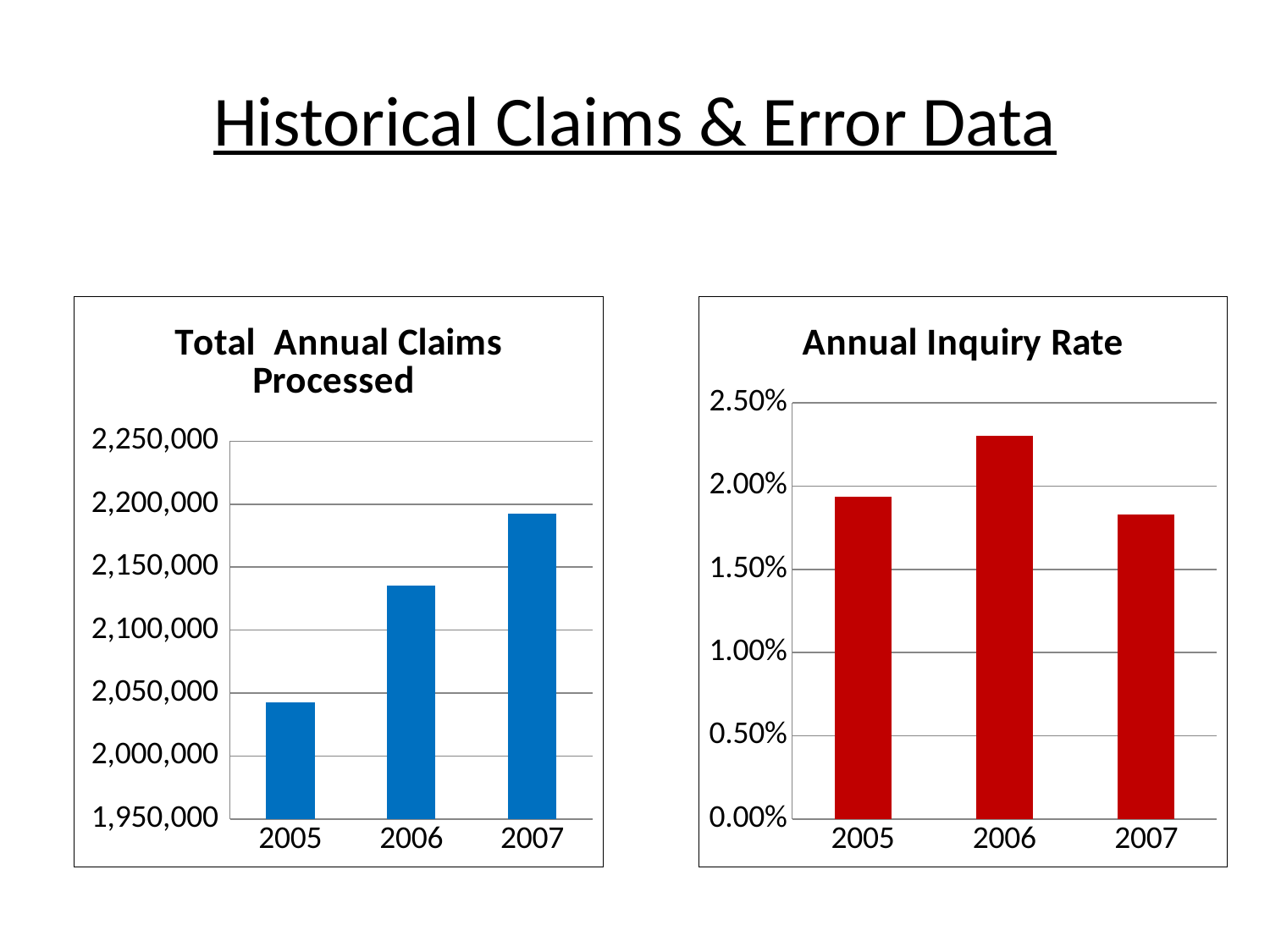
In the "Annual Inquiry Rate" chart, which year has a higher inquiry rate, 2005 or 2007? 2005 In the "Annual Inquiry Rate" chart, which year has the highest inquiry rate? 2006 In the "Total Annual Claims Processed" chart, do the values rise or fall from 2005 to 2007? rise What kind of chart is the "Total Annual Claims Processed" chart? bar chart In the "Annual Inquiry Rate" chart, which year has the lowest inquiry rate? 2007 In the "Annual Inquiry Rate" chart, is the value for 2006 greater or less than 2.00%? greater In the "Total Annual Claims Processed" chart, which year has the highest value? 2007 In the "Total Annual Claims Processed" chart, is the value for 2007 greater or less than 2,150,000? greater In the "Total Annual Claims Processed" chart, is the value for 2005 greater or less than 2,050,000? less How many years are shown on the "Annual Inquiry Rate" chart? 3 What colour are the bars in the "Annual Inquiry Rate" chart? red In the "Total Annual Claims Processed" chart, which year has the lowest value? 2005